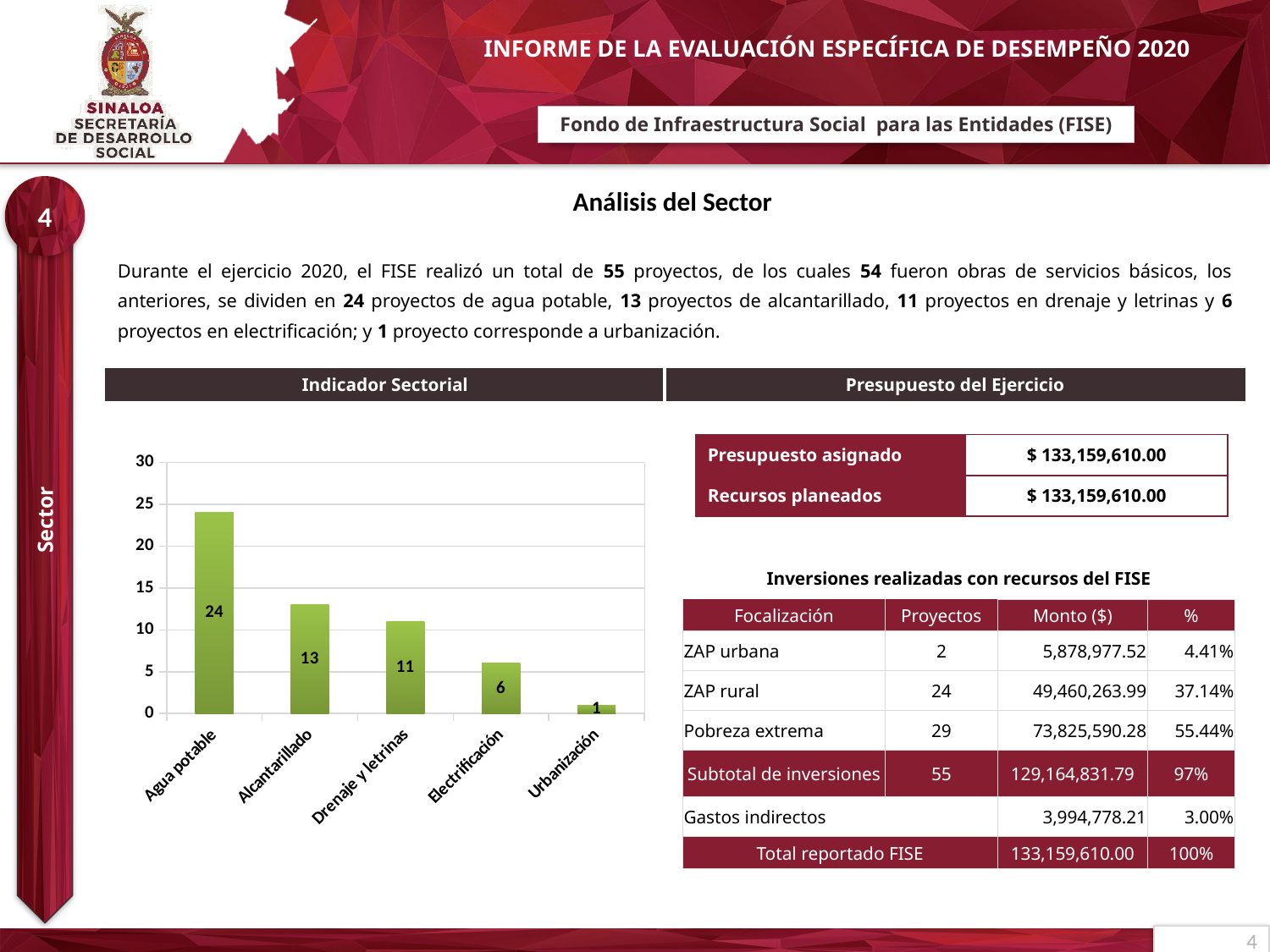
What is the difference between the values for Agua potable and Alcantarillado in the bar chart? 11 What is the value for Electrificación in the bar chart? 6 Which is larger in the bar chart, Drenaje y letrinas or Electrificación? Drenaje y letrinas What is the value for Drenaje y letrinas in the bar chart? 11 What is the value for Agua potable in the bar chart? 24 How many categories are shown in the bar chart? 5 What is the value for Urbanización in the bar chart? 1 Which category has the highest value in the bar chart? Agua potable What is the value for Alcantarillado in the bar chart? 13 What kind of chart is shown on the slide? Bar chart Do the values in the bar chart rise or fall from left to right along the x axis? Fall Which category has the lowest value in the bar chart? Urbanización